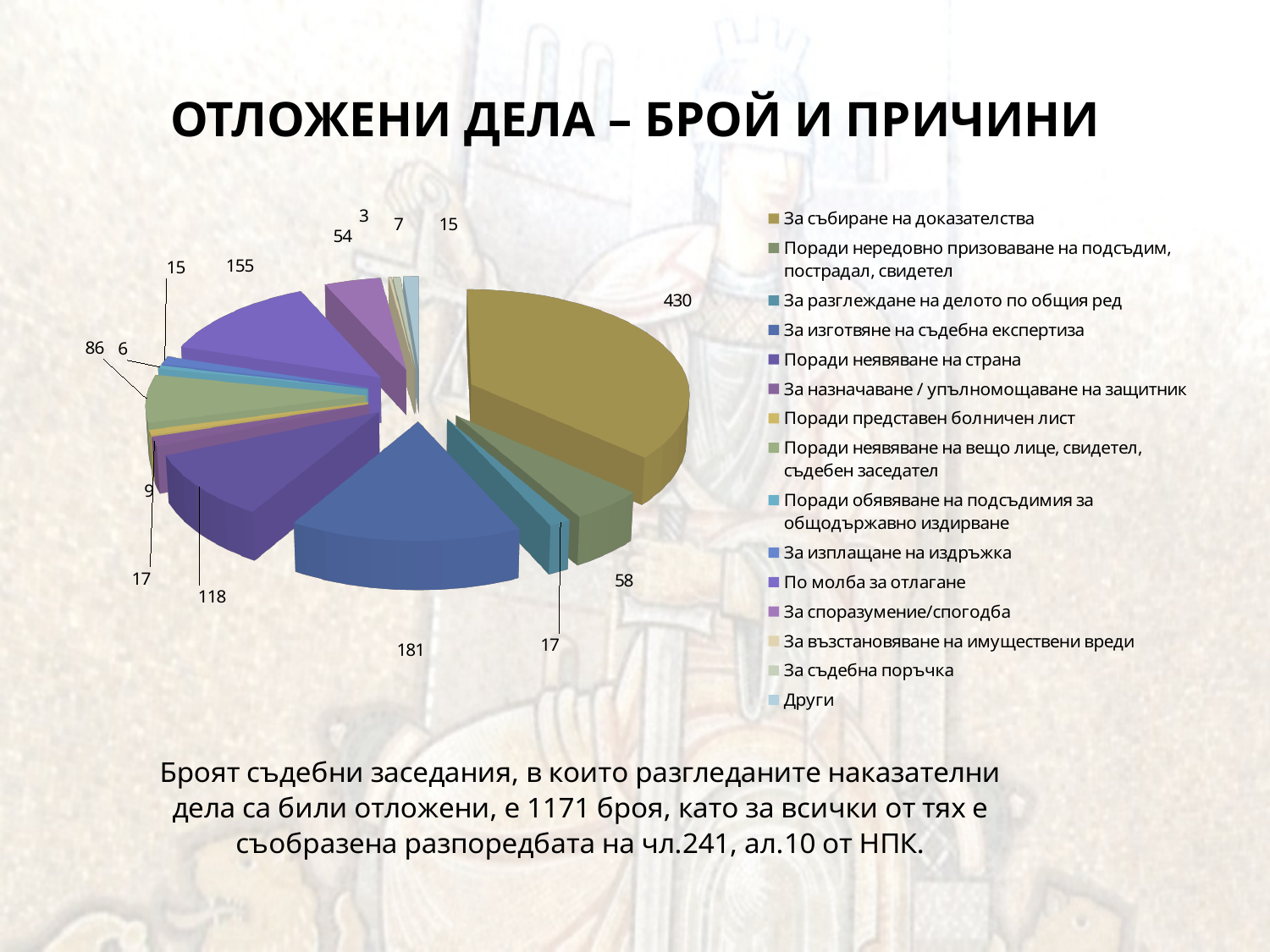
What is the title of the slide containing the pie chart? ОТЛОЖЕНИ ДЕЛА – БРОЙ И ПРИЧИНИ What is the value for 'Поради неявяване на страна'? 118 What is the value for 'По молба за отлагане'? 155 How many categories does the legend of the pie chart list? 15 What is the difference between the values for 'За събиране на доказателства' (430) and 'За изготвяне на съдебна експертиза' (181)? 249 What is the smallest value shown as a data label on the pie chart? 3 What is the value of the largest slice in the pie chart? 430 What is the value for 'Поради нередовно призоваване на подсъдим, пострадал, свидетел'? 58 What is the value for 'За изготвяне на съдебна експертиза'? 181 Which is larger: the slice for 'По молба за отлагане' or the slice for 'Поради неявяване на страна'? По молба за отлагане Which category has the largest slice in the pie chart? За събиране на доказателства What type of chart is shown on the slide? pie chart